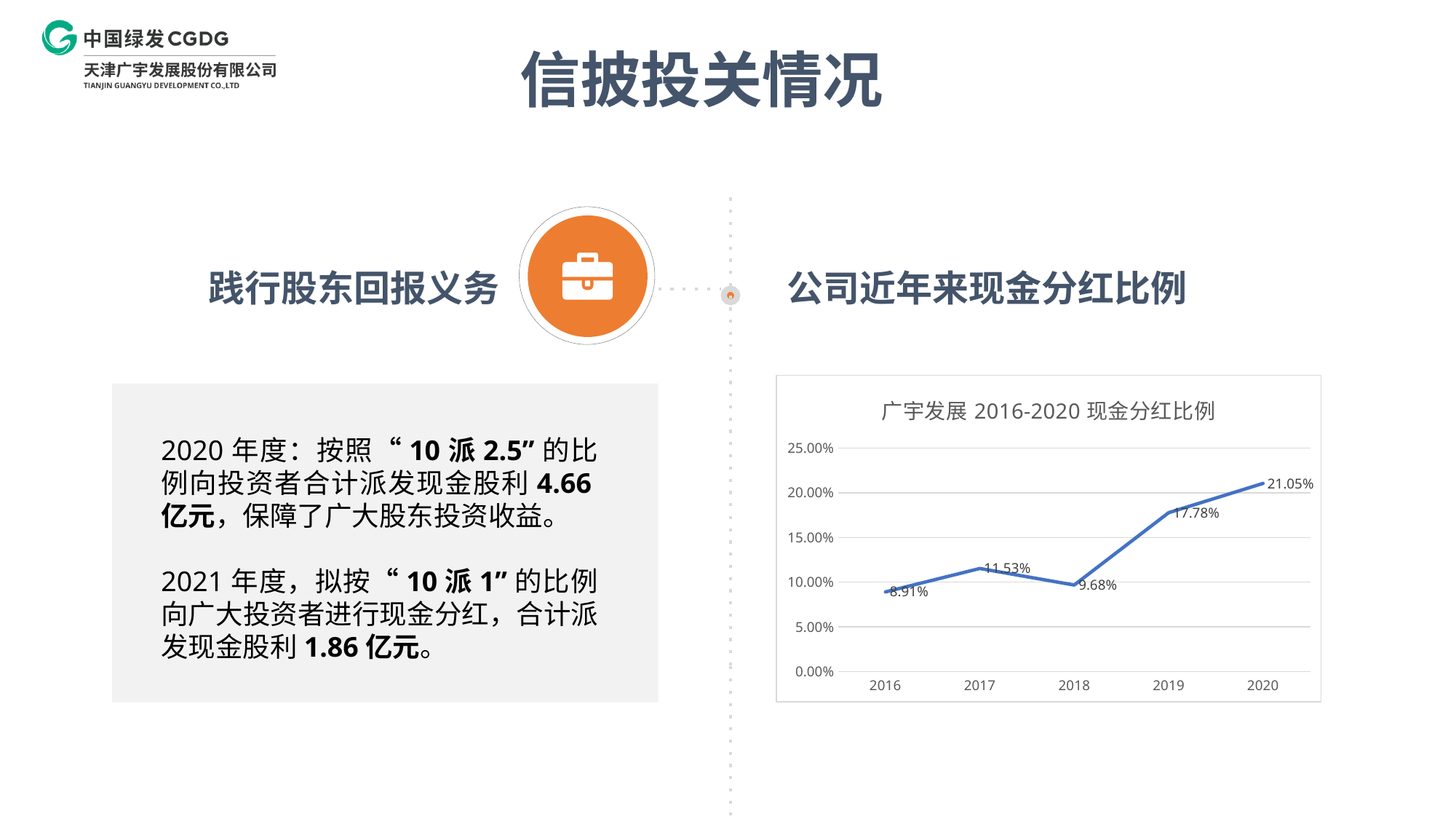
Which year has the lowest cash dividend ratio? 2016 What is the cash dividend ratio for 2018? 9.68% Which year has a higher cash dividend ratio, 2017 or 2018? 2017 What is the cash dividend ratio for 2016? 8.91% What is the title of the chart? 广宇发展 2016-2020 现金分红比例 What type of chart is shown on the slide? Line chart Is the value for 2019 greater or less than 15.00%? greater What is the difference between the 2020 and 2019 cash dividend ratios? 3.27% How many years are plotted on the chart? 5 What is the cash dividend ratio for 2019? 17.78% What is the cash dividend ratio for 2020? 21.05% Which year has the highest cash dividend ratio? 2020